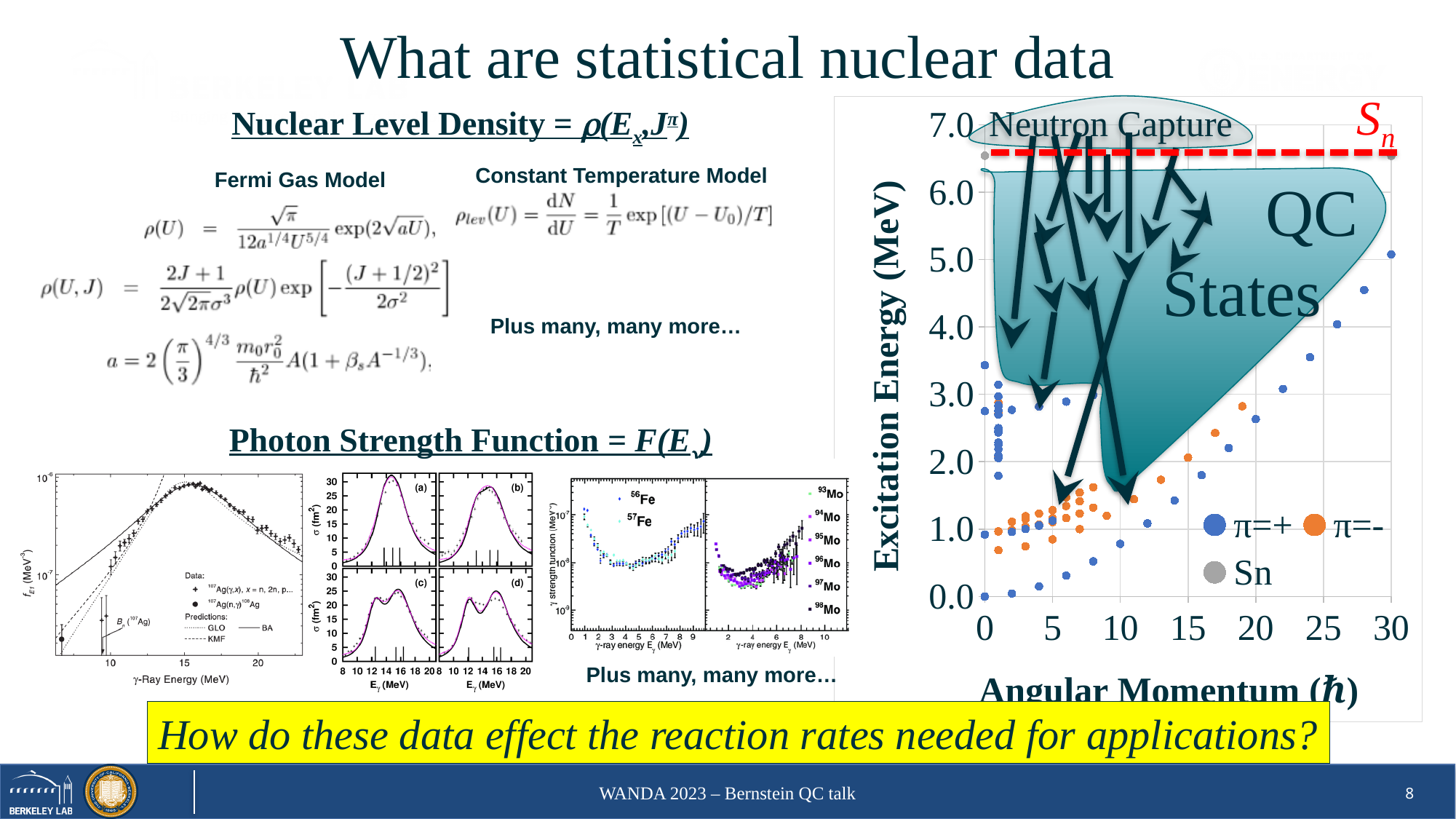
In the Excitation Energy vs Angular Momentum chart, is the π=+ point at angular momentum 20 greater or less than 3.0 MeV? less What are the legend entries of the Excitation Energy vs Angular Momentum chart? π=+, π=-, Sn What is the y-axis label of the Excitation Energy vs Angular Momentum chart? Excitation Energy (MeV) What is the highest value shown on the x axis of the Excitation Energy vs Angular Momentum chart? 30 What kind of chart is the large chart on the right of the slide (Excitation Energy vs Angular Momentum)? scatter chart How many series does the legend of the Excitation Energy vs Angular Momentum chart list? 3 What is the highest tick value shown on the y axis of the Excitation Energy vs Angular Momentum chart? 7.0 In the Excitation Energy vs Angular Momentum chart, which series is plotted in orange? π=- In the Excitation Energy vs Angular Momentum chart, is the π=+ point at angular momentum 30 greater or less than 4.0 MeV? greater In the Excitation Energy vs Angular Momentum chart, is the red dashed Sn line greater or less than 6.0 MeV? greater In the Excitation Energy vs Angular Momentum chart, do the lowest π=+ points generally rise or fall as angular momentum increases? rise